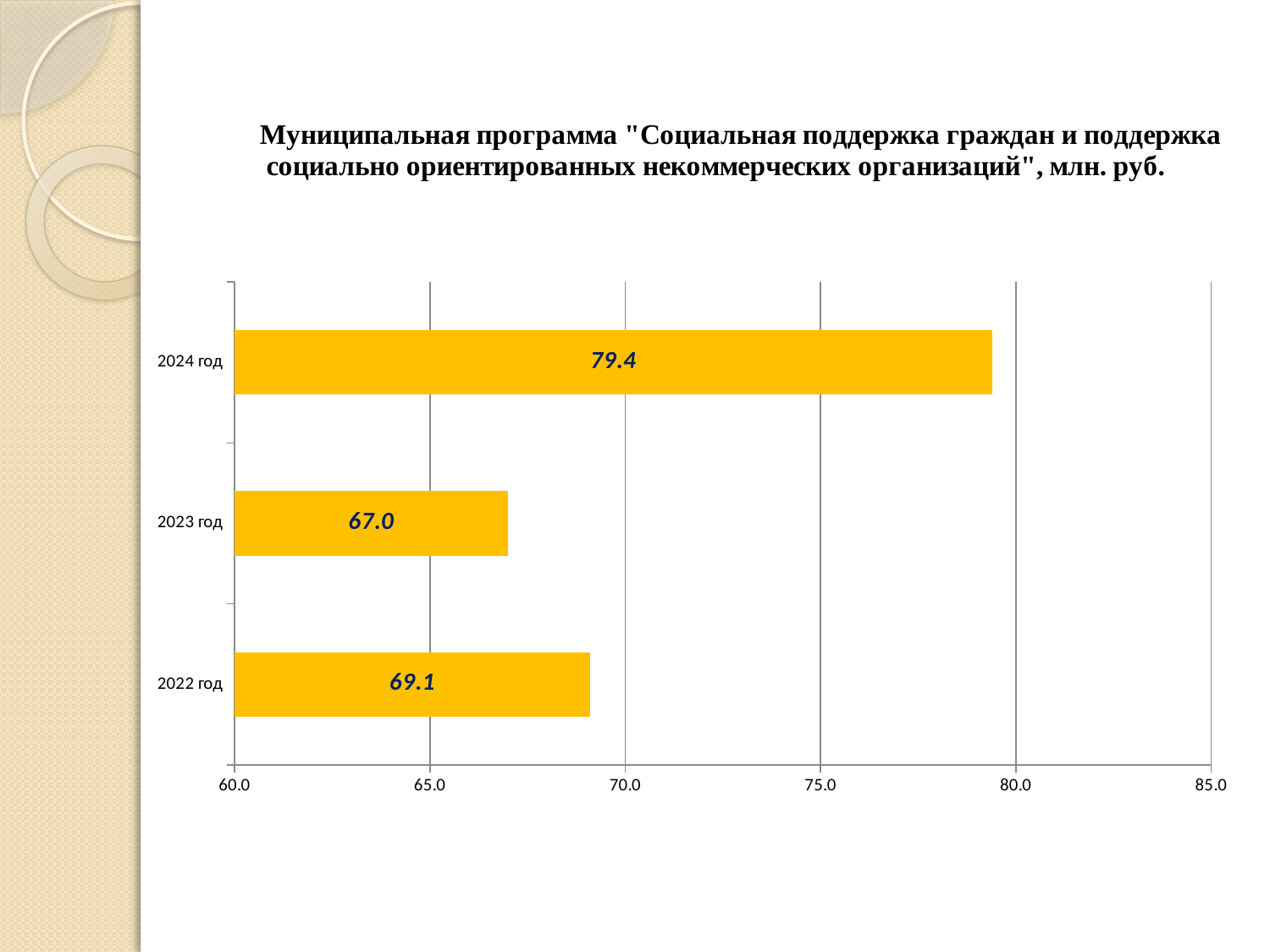
What is the value for 2023 год? 67.0 What is the value for 2022 год? 69.1 Which is larger, the value for 2022 год or the value for 2023 год? 2022 год What unit is given in the chart title? млн. руб. Which year has the highest value? 2024 год Is the value for 2024 год greater or less than 75.0? greater What is the difference between the values for 2022 год and 2023 год? 2.1 What is the difference between the values for 2024 год and 2023 год? 12.4 What is the value for 2024 год? 79.4 How many years are shown in the chart? 3 Which year has the lowest value? 2023 год What kind of chart is shown on the slide? bar chart